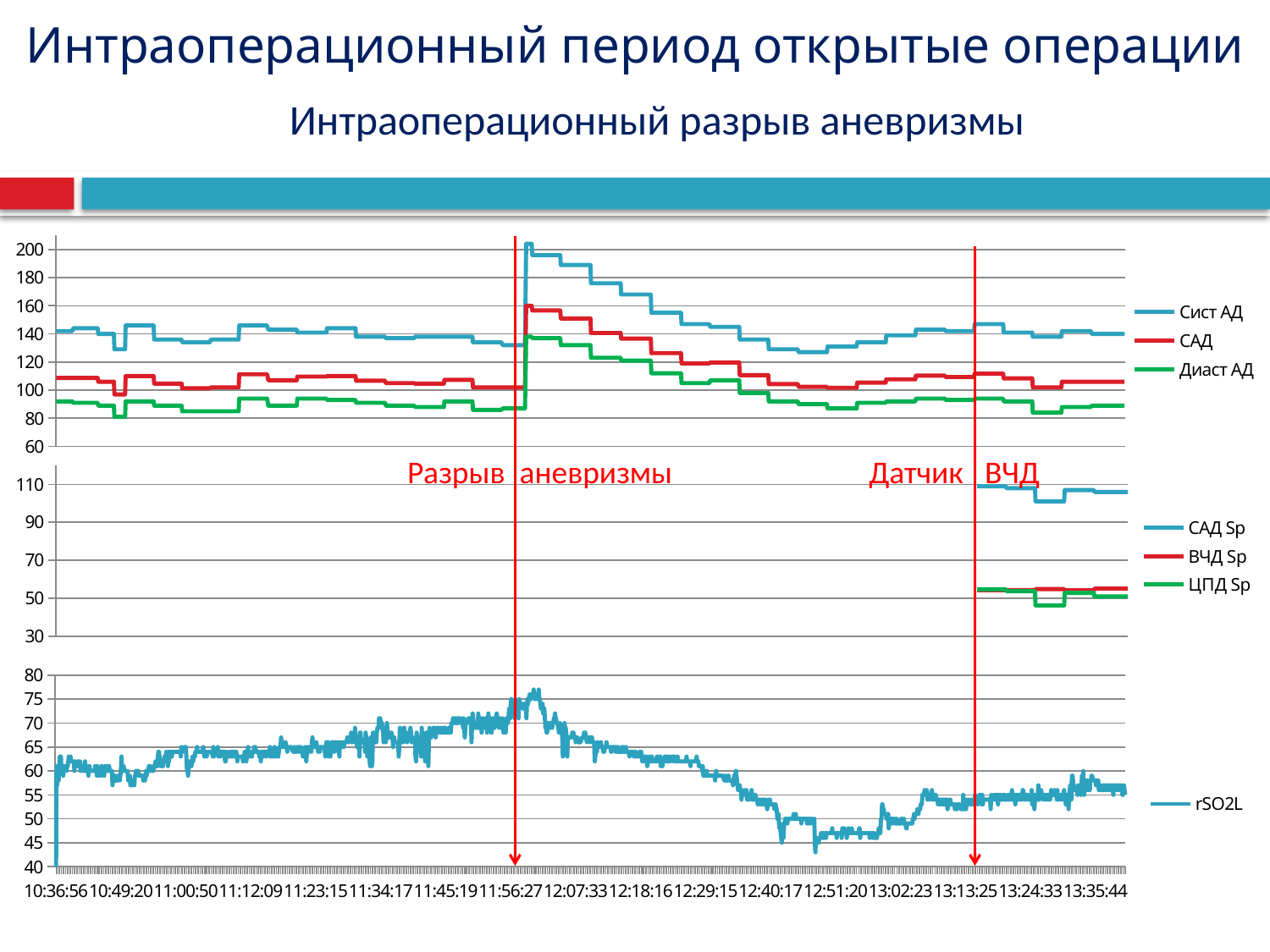
What kind of chart is the top chart (Сист АД, САД, Диаст АД)? line chart In the middle chart, is the value of САД Sp after the 'Датчик ВЧД' line greater or less than 90? greater What event is labelled at the first red vertical line on the charts? Разрыв аневризмы In the top chart, is the peak value of Сист АД just after the 'Разрыв аневризмы' line greater or less than 180? greater In the bottom chart, does rSO2L rise or fall between 11:56:27 and 12:51:20? fall In the middle chart, which series is higher after the 'Датчик ВЧД' line: САД Sp or ВЧД Sp? САД Sp In the top chart, which series is higher throughout: Сист АД or Диаст АД? Сист АД In the bottom chart, is the value of rSO2L around 12:51:20 greater or less than 50? less How many series does the legend of the bottom chart list? 1 How many series does the legend of the top chart list? 3 How many series does the legend of the middle chart (САД Sp, ВЧД Sp, ЦПД Sp) list? 3